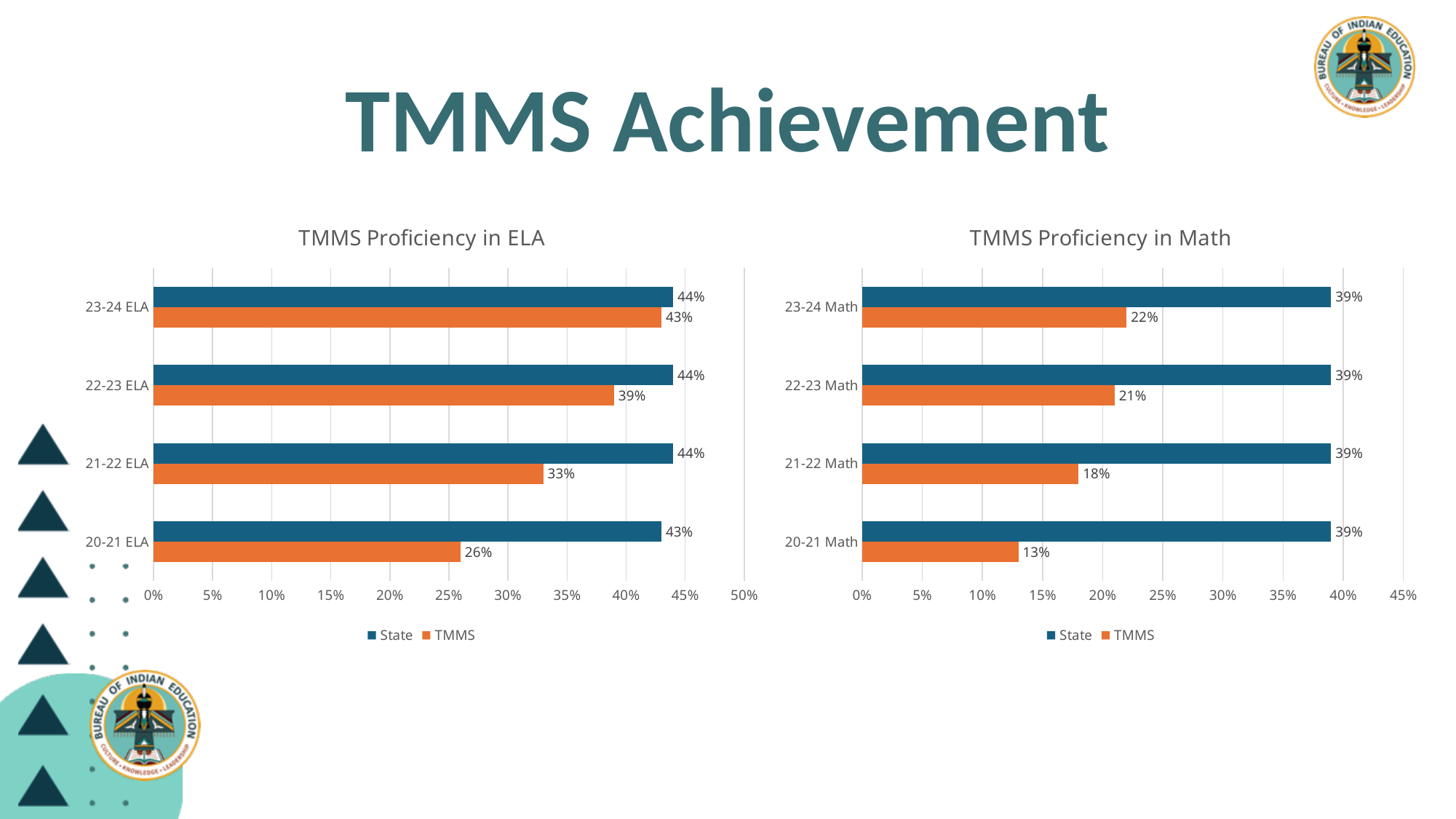
How many series does the legend of the 'TMMS Proficiency in Math' chart list? 2 In the 'TMMS Proficiency in ELA' chart, what is the difference between the State and TMMS values for 21-22 ELA? 11% In the 'TMMS Proficiency in ELA' chart, which category has the lowest TMMS value? 20-21 ELA In the 'TMMS Proficiency in Math' chart, what is the difference between the State and TMMS values for 23-24 Math? 17% In the 'TMMS Proficiency in ELA' chart, do the TMMS values rise or fall from 20-21 ELA to 23-24 ELA? rise In the 'TMMS Proficiency in Math' chart, which category has the highest TMMS value? 23-24 Math In the 'TMMS Proficiency in Math' chart, what is the TMMS value for 20-21 Math? 13% How many categories are shown in the 'TMMS Proficiency in ELA' chart? 4 In the 'TMMS Proficiency in Math' chart, is the TMMS value for 22-23 Math larger or smaller than the TMMS value for 21-22 Math? larger What kind of chart is 'TMMS Proficiency in Math'? bar chart In the 'TMMS Proficiency in ELA' chart, what is the TMMS value for 23-24 ELA? 43% In the 'TMMS Proficiency in ELA' chart, what is the State value for 20-21 ELA? 43%